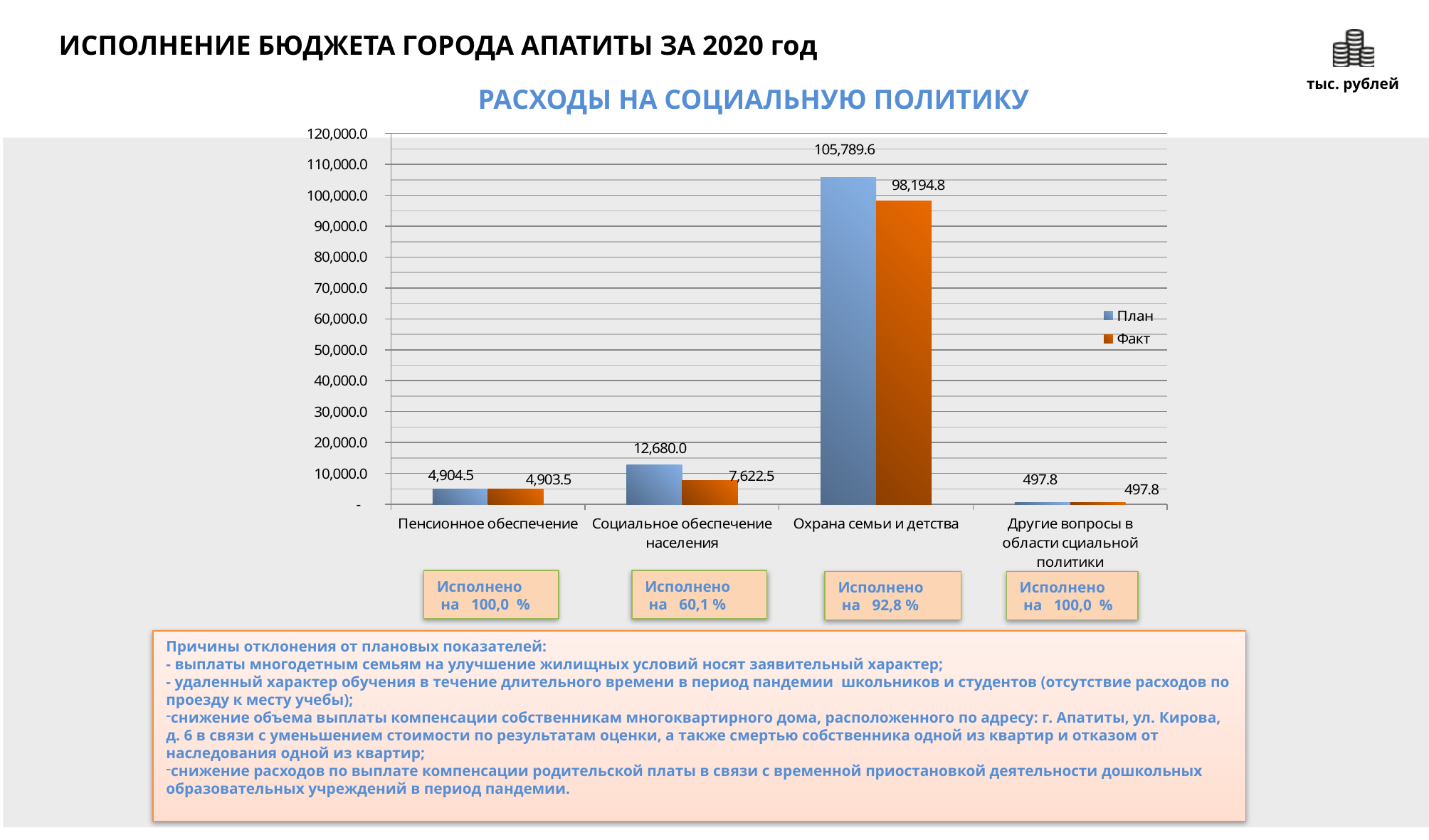
What is the Факт value for Пенсионное обеспечение? 4,903.5 What is the План value for Охрана семьи и детства? 105,789.6 What is the План value for Другие вопросы в области сциальной политики? 497.8 What type of chart is shown on the slide? Bar chart Which category has the highest Факт value? Охрана семьи и детства What is the difference between the План and Факт values for Социальное обеспечение населения? 5,057.5 What is the Факт value for Социальное обеспечение населения? 7,622.5 How many categories are shown on the x axis of the chart? 4 What is the difference between the План and Факт values for Охрана семьи и детства? 7,594.8 Which is larger for Социальное обеспечение населения, the План value or the Факт value? План Which category has the lowest План value? Другие вопросы в области сциальной политики How many series does the chart legend list? 2